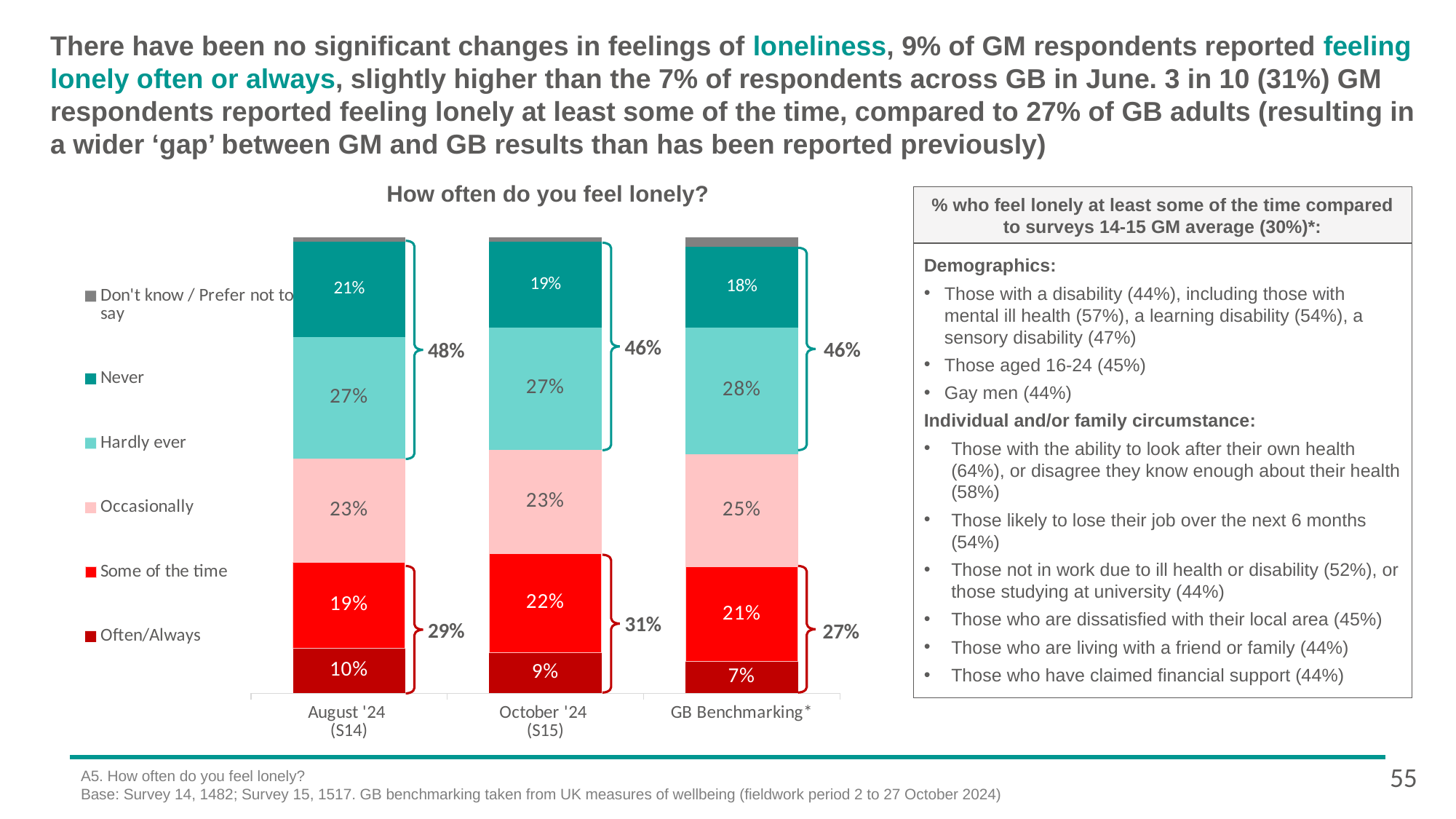
What is the difference between the Occasionally value for GB Benchmarking* and for August '24 (S14)? 2% What percentage of respondents said Some of the time in October '24 (S15)? 22% What is the combined share of Often/Always and Some of the time for October '24 (S15), as shown by the bracket label? 31% Which bar has the highest Some of the time value? October '24 (S15) Is the Never value larger for August '24 (S14) or for GB Benchmarking*? August '24 (S14) What percentage of respondents said Often/Always in August '24 (S14)? 10% How many series does the legend of the "How often do you feel lonely?" chart list? 6 Which bar has the lowest Often/Always value? GB Benchmarking* What type of chart is shown under the title "How often do you feel lonely?"? Stacked bar chart How many bars (survey waves/benchmarks) are shown on the x axis of the chart? 3 What is the Never value for October '24 (S15)? 19% What is the Hardly ever value for GB Benchmarking*? 28%